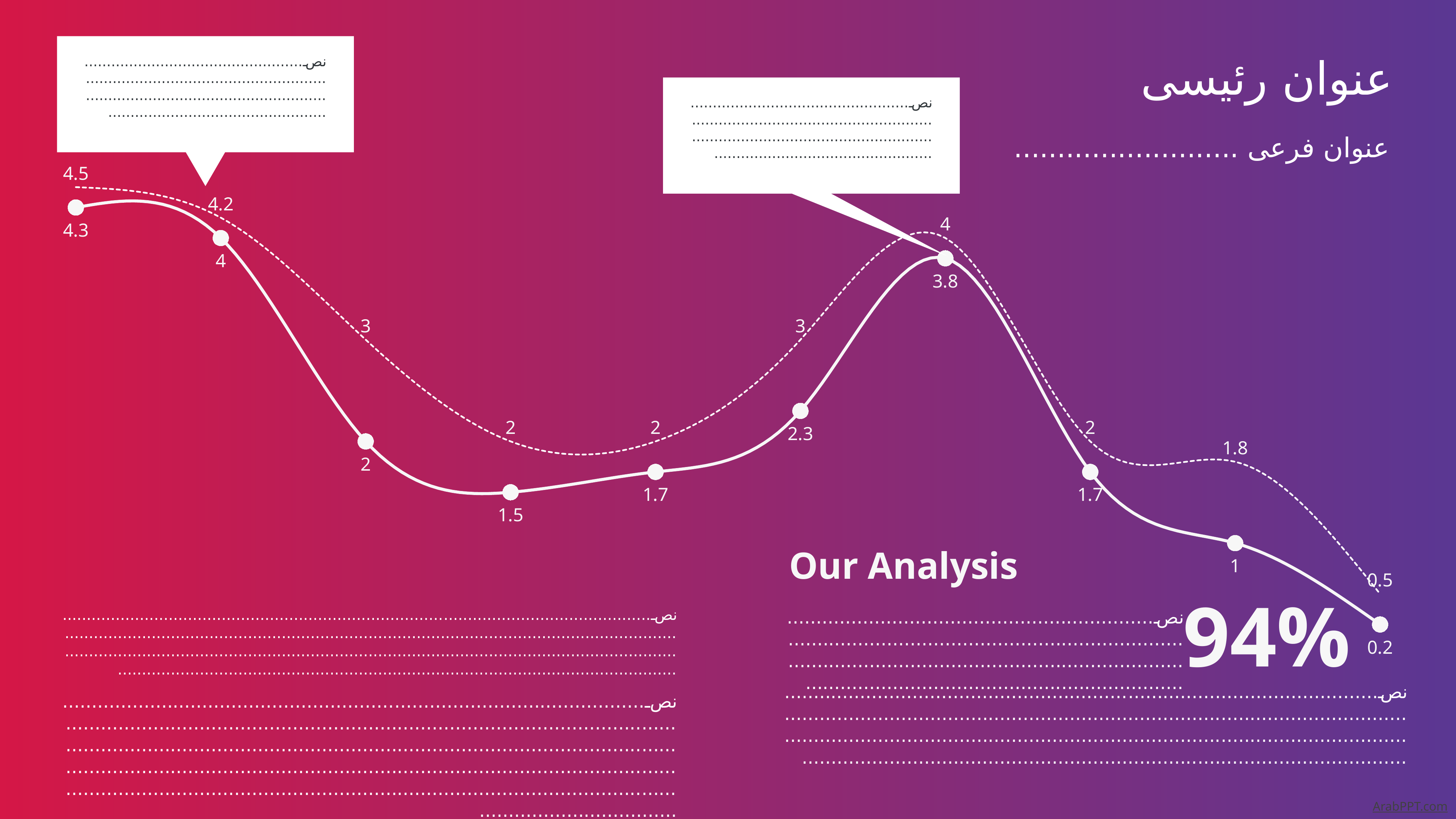
What kind of chart is shown on the slide? line chart What is the highest value labelled on the dashed line? 4.5 At the first point, which line has the larger value, the dashed line (4.5) or the solid line (4.3)? dashed line How many lines are plotted on the chart? 2 Overall, do the values on the solid line rise or fall from the first point to the last point? fall How many data points are marked on the solid line? 10 What is the value of the last point on the solid line? 0.2 What is the lowest value labelled on the solid line? 0.2 What is the lowest value labelled on the dashed line? 0.5 What large percentage figure is displayed near the bottom right of the chart? 94% What is the value of the first point on the solid line? 4.3 What is the difference between the first and last values on the solid line (4.3 and 0.2)? 4.1